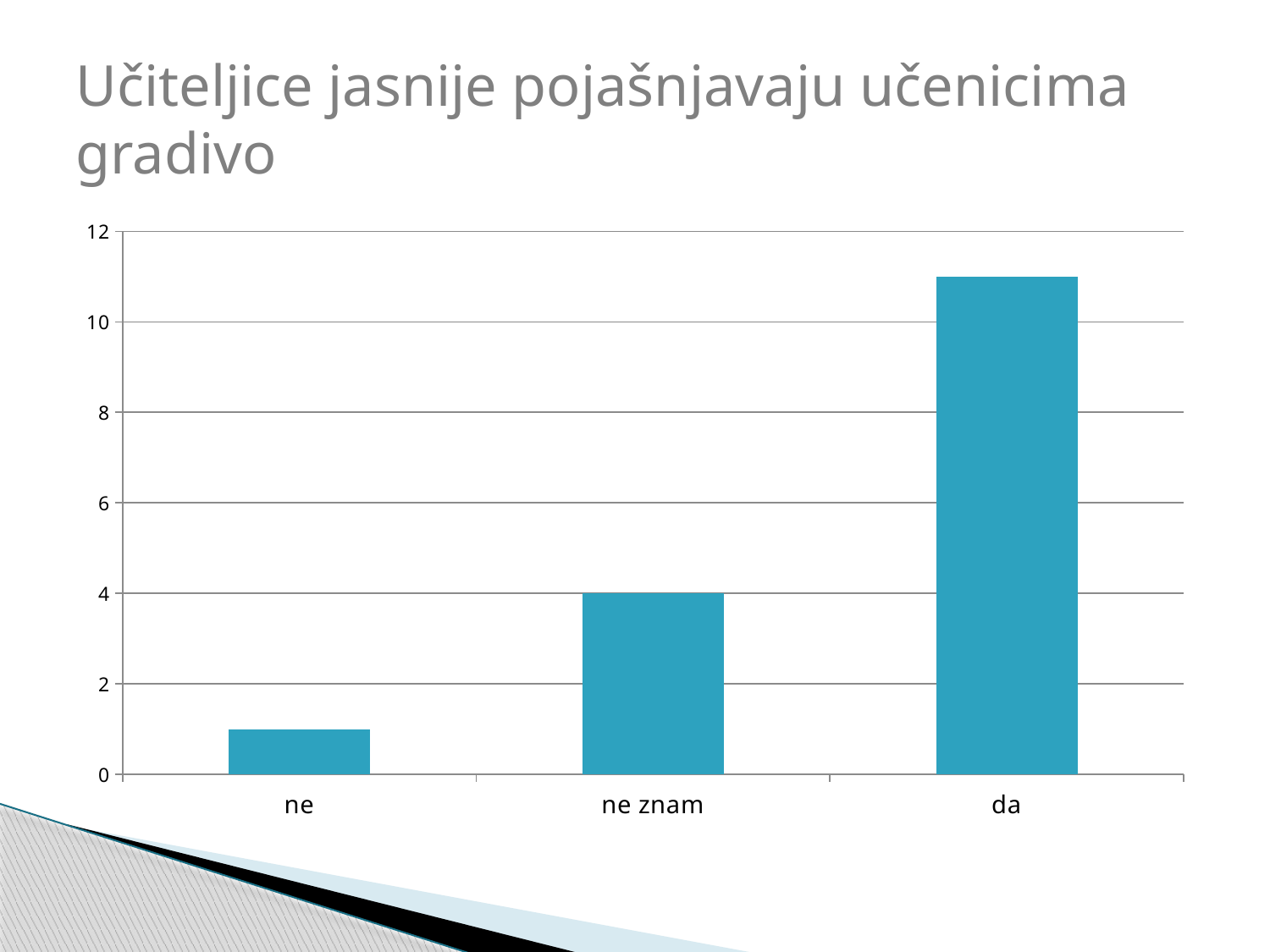
What is the highest value shown on the vertical axis? 12 Do the values rise or fall from left to right along the x axis? rise Which category has the highest value? da How many categories are shown on the x axis of the chart? 3 What is the value for "ne znam"? 4 Which is larger, the value for "ne znam" or the value for "da"? da Which is larger, the value for "ne" or the value for "ne znam"? ne znam What kind of chart is shown on the slide? bar chart Is the value for "ne" greater or less than 2? less Is the value for "ne znam" greater or less than 6? less Is the value for "da" greater or less than 10? greater Which category has the lowest value? ne